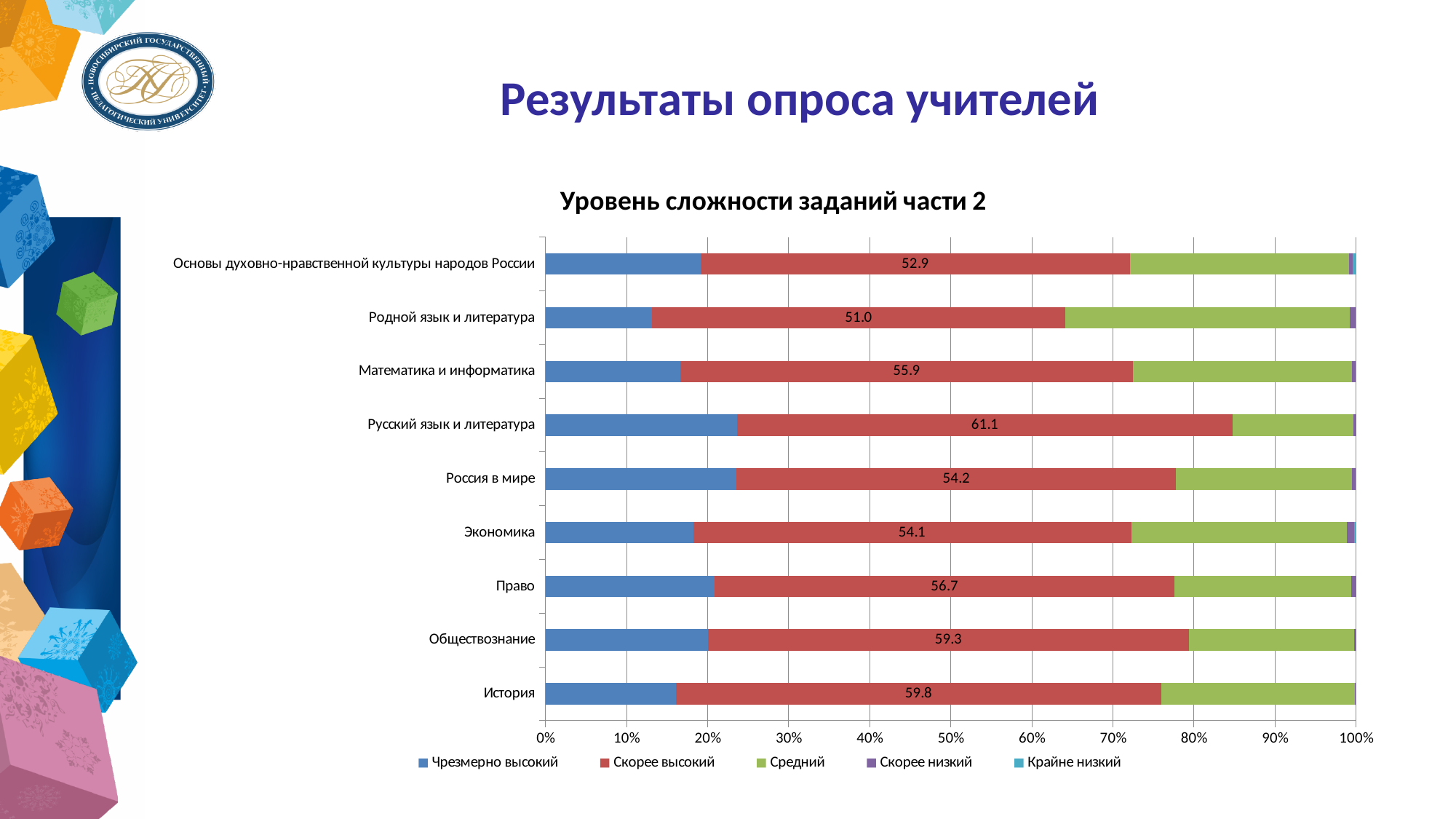
What is the difference between the 'Скорее высокий' values for 'Русский язык и литература' and 'Родной язык и литература'? 10.1 Which has a larger 'Скорее высокий' value: 'Право' or 'Экономика'? Право How many subject categories are shown on the chart? 9 Which category has the lowest 'Скорее высокий' value? Родной язык и литература Which category has the highest 'Скорее высокий' value? Русский язык и литература How many series does the legend list? 5 What is the title of the chart? Уровень сложности заданий части 2 What is the value of the 'Скорее высокий' series for 'Математика и информатика'? 55.9 What type of chart is shown on the slide? Stacked bar chart What is the value of the 'Скорее высокий' series for 'История'? 59.8 Is the 'Чрезмерно высокий' value for 'Родной язык и литература' greater or less than 20%? less What is the value of the 'Скорее высокий' series for 'Русский язык и литература'? 61.1